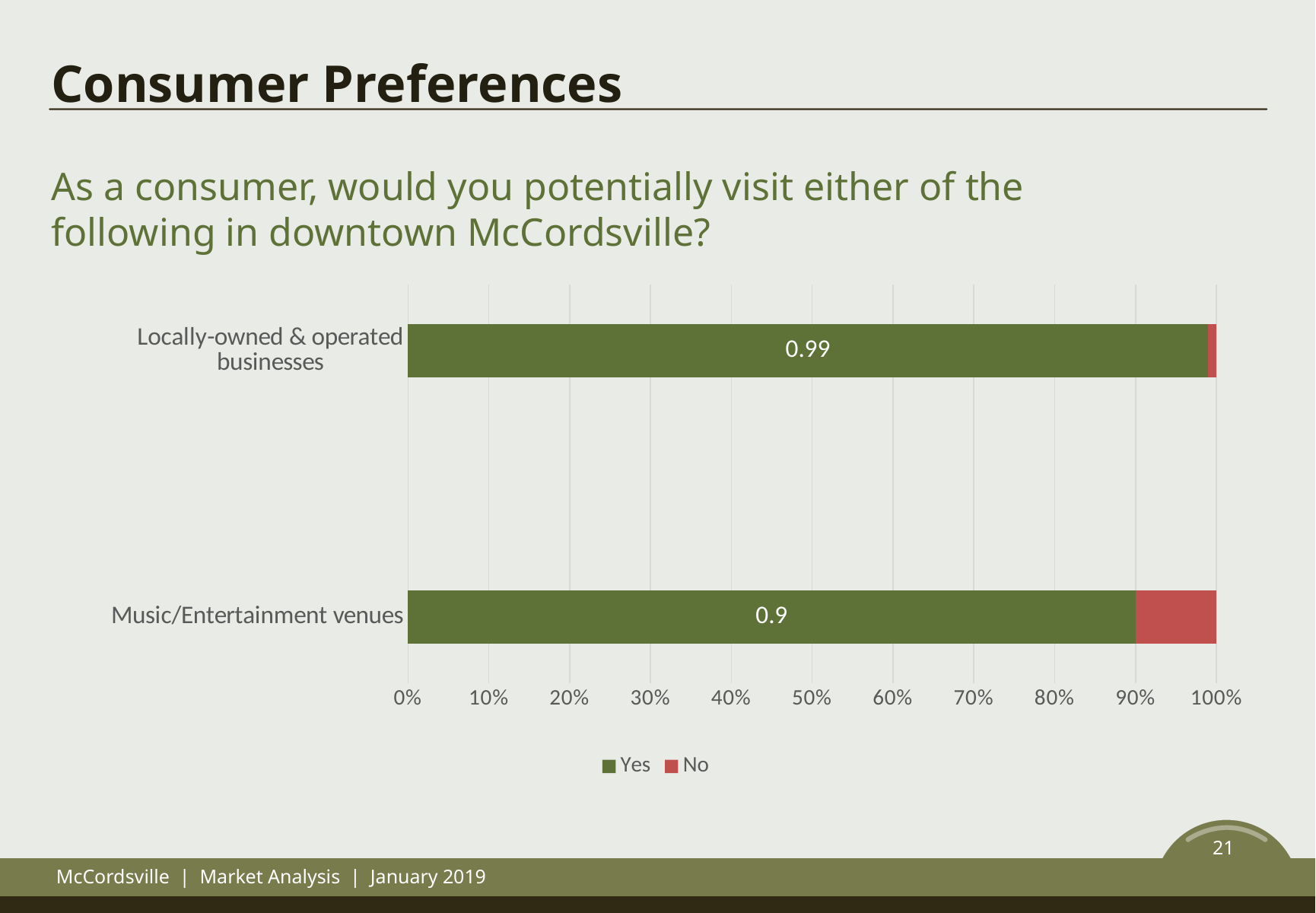
What is the difference between the Yes values for Locally-owned & operated businesses and Music/Entertainment venues? 0.09 How many categories are shown in the chart? 2 Which has a larger Yes value: Locally-owned & operated businesses or Music/Entertainment venues? Locally-owned & operated businesses What are the two legend entries in the chart? Yes and No Which category has the highest Yes value? Locally-owned & operated businesses Is the No value for Music/Entertainment venues greater or less than 20%? less What kind of chart is shown on the slide? bar chart What is the Yes value for Music/Entertainment venues? 0.9 What is the Yes value for Locally-owned & operated businesses? 0.99 Is the No value for Locally-owned & operated businesses greater or less than 10%? less How many series does the legend list? 2 Which category has the lowest Yes value? Music/Entertainment venues